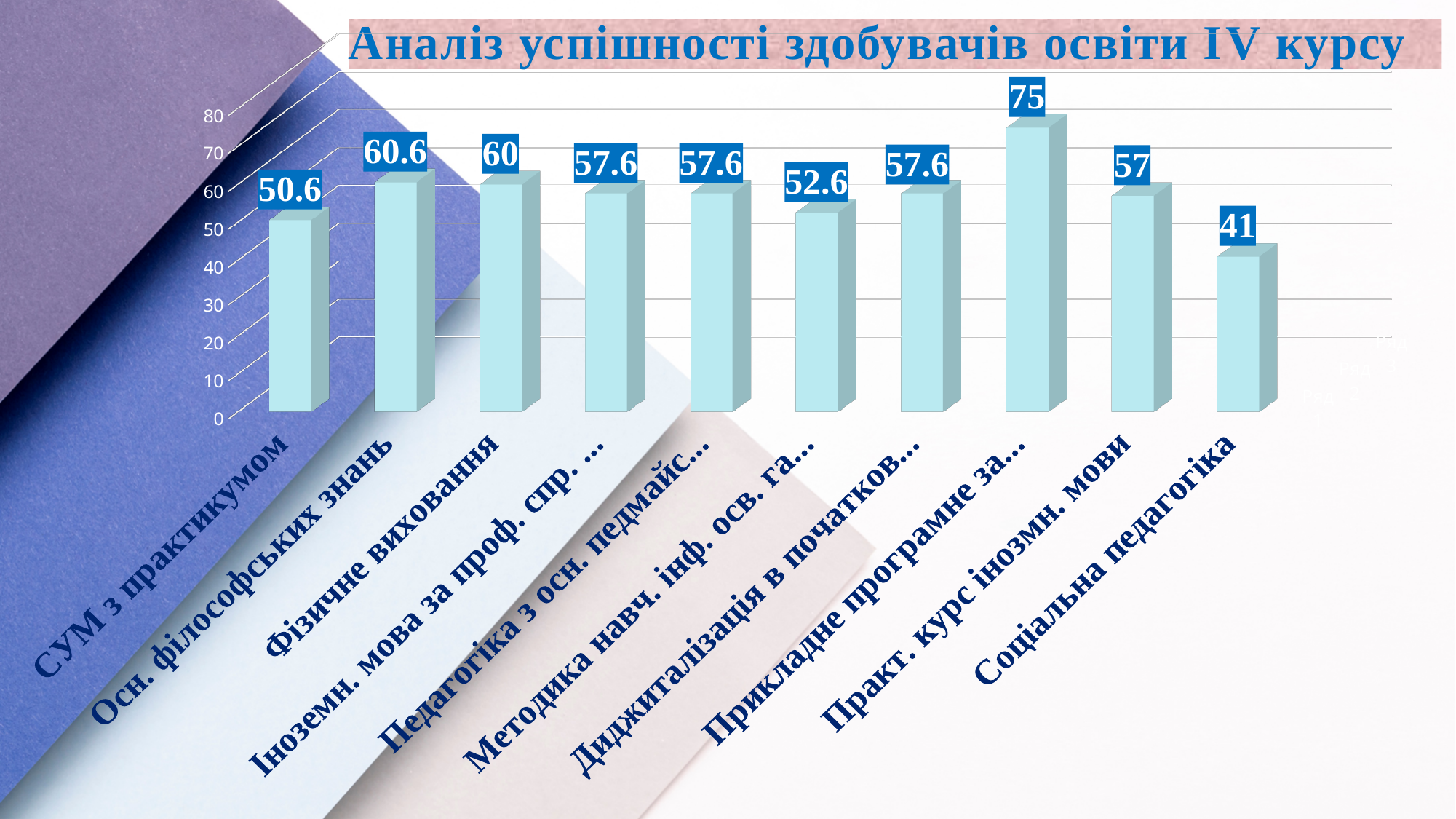
Which is larger, the value for Осн. філософських знань or the value for Фізичне виховання? Осн. філософських знань Which category has the lowest value? Соціальна педагогіка What kind of chart is shown on the slide? Bar chart How many categories are shown on the chart? 10 What is the title of the chart? Аналіз успішності здобувачів освіти IV курсу What is the difference between the highest and lowest values on the chart? 34 What is the value for Соціальна педагогіка? 41 What is the value for СУМ з практикумом? 50.6 What is the difference between the values for Осн. філософських знань and СУМ з практикумом? 10 What is the value for Практ. курс інозмн. мови? 57 What is the value for Фізичне виховання? 60 Which category has the highest value? Прикладне програмне за...